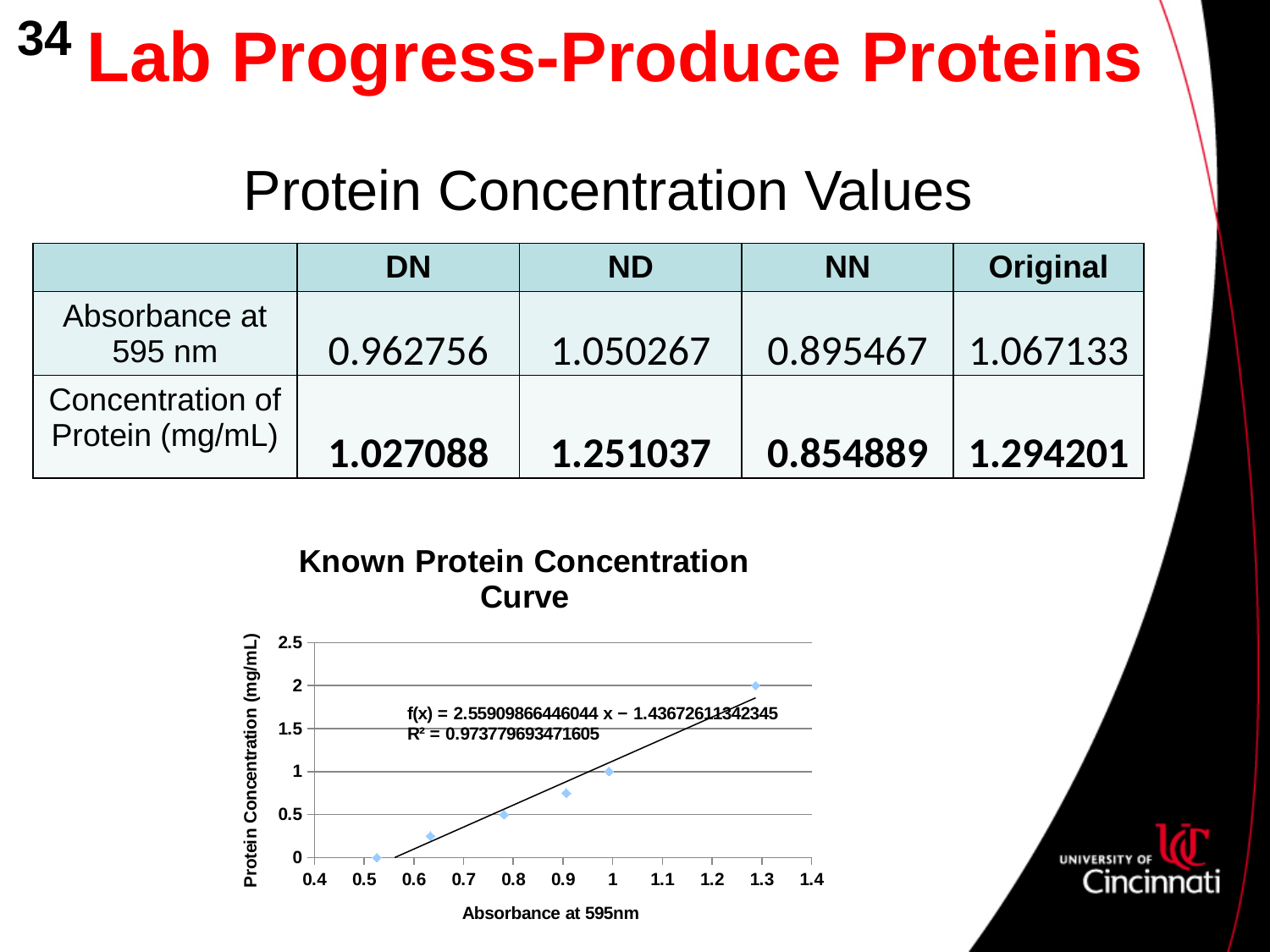
In the 'Known Protein Concentration Curve' chart, is the absorbance of the leftmost point greater or less than 0.6? less What is the highest value shown on the y axis of the 'Known Protein Concentration Curve' chart? 2.5 In the 'Known Protein Concentration Curve' chart, is the protein concentration of the rightmost point greater or less than 1.5? greater In the 'Known Protein Concentration Curve' chart, does protein concentration rise or fall as absorbance increases? rise What is the slope of the trendline equation shown on the 'Known Protein Concentration Curve' chart? 2.55909866446044 What is the x-axis label of the 'Known Protein Concentration Curve' chart? Absorbance at 595nm How many points in the 'Known Protein Concentration Curve' chart have a protein concentration above 1.5 mg/mL? 1 What is the R² value shown on the 'Known Protein Concentration Curve' chart? 0.973779693471605 In the 'Known Protein Concentration Curve' chart, is the protein concentration of the point at about 0.9 absorbance greater or less than 1? less What kind of chart is the 'Known Protein Concentration Curve'? scatter chart How many data points are plotted in the 'Known Protein Concentration Curve' chart? 6 What is the title of the chart on the slide? Known Protein Concentration Curve